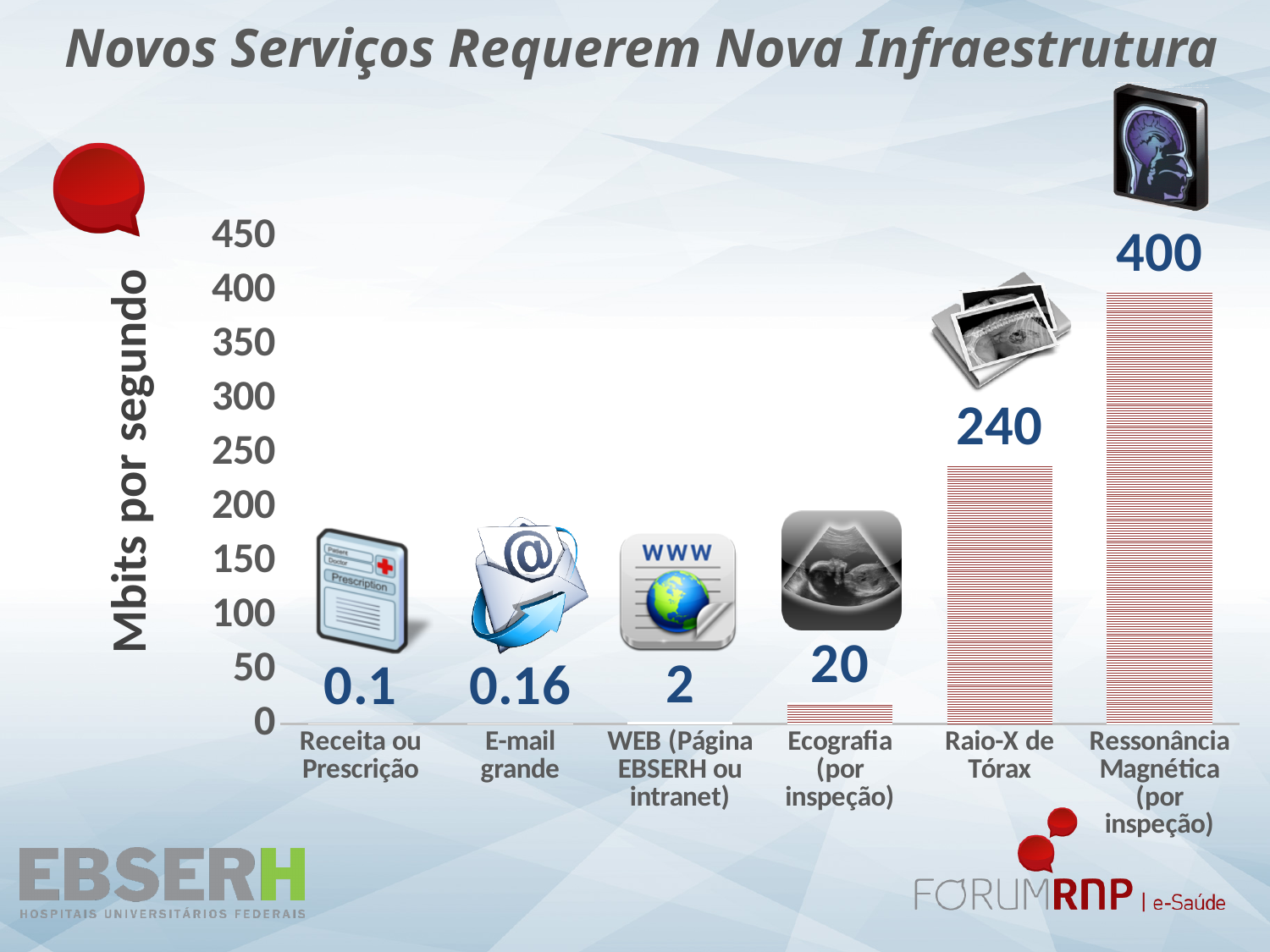
What is the value for Raio-X de Tórax? 240 What kind of chart is shown on the slide? bar chart What is the difference between the values for Ressonância Magnética (por inspeção) and Raio-X de Tórax? 160 Which is larger, the value for Ecografia (por inspeção) or the value for WEB (Página EBSERH ou intranet)? Ecografia (por inspeção) What is the value for Ecografia (por inspeção)? 20 How many categories are shown on the x axis? 6 What is the label of the vertical axis? Mbits por segundo Is the value for Raio-X de Tórax greater or less than 200? greater What is the value for E-mail grande? 0.16 Which category has the lowest value? Receita ou Prescrição What is the value for WEB (Página EBSERH ou intranet)? 2 Which category has the highest value? Ressonância Magnética (por inspeção)